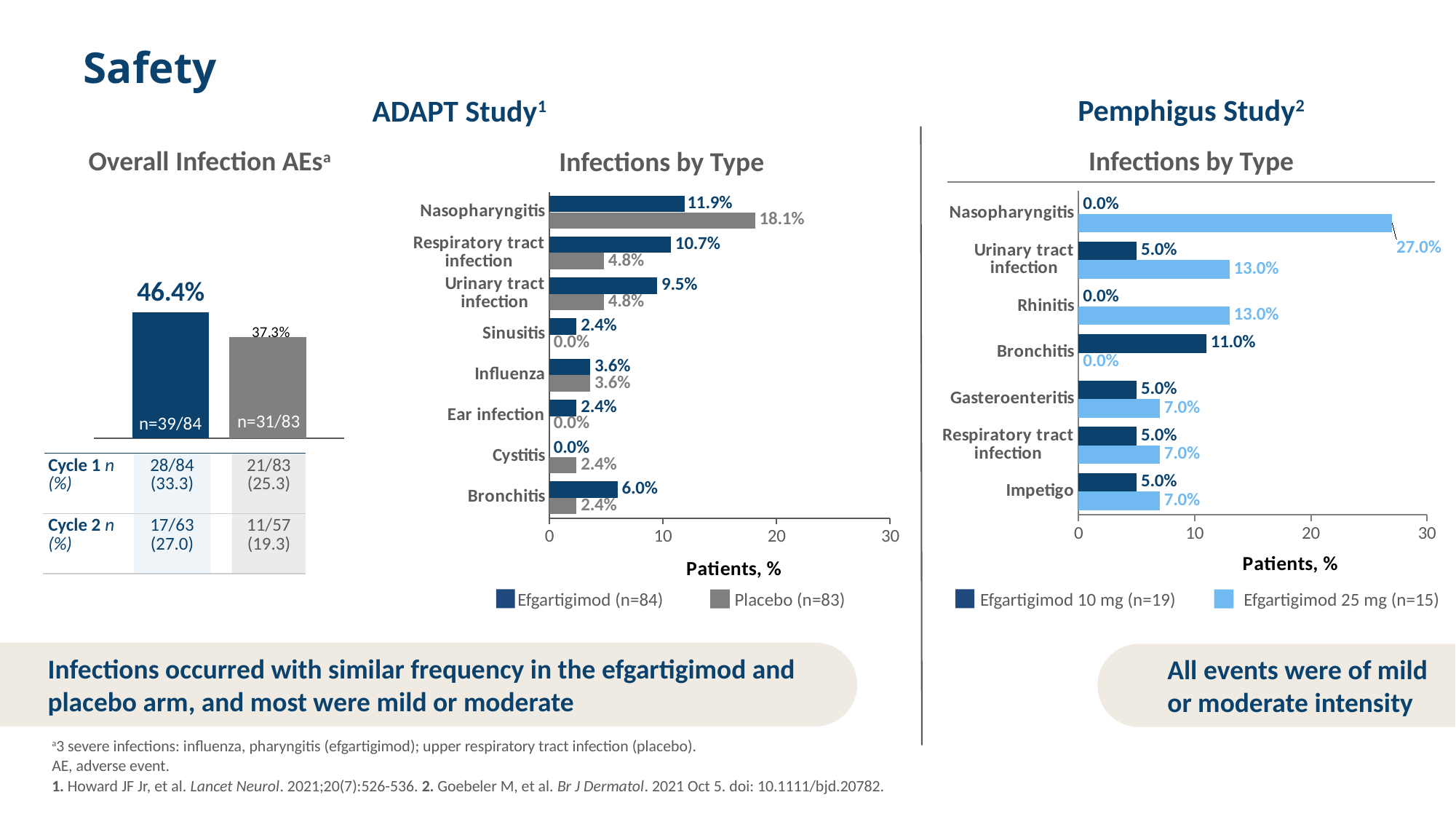
In the Overall Infection AEs chart, what percentage is shown for the efgartigimod bar? 46.4% In the ADAPT Study Infections by Type chart, what is the difference between the efgartigimod and placebo values for respiratory tract infection? 5.9% In the Pemphigus Study Infections by Type chart, how many series does the legend list? 2 In the ADAPT Study Infections by Type chart, which infection type has the highest efgartigimod value? Nasopharyngitis In the ADAPT Study Infections by Type chart, what is the placebo value for nasopharyngitis? 18.1% In the Pemphigus Study Infections by Type chart, which infection type has the highest efgartigimod 10 mg value? Bronchitis In the Pemphigus Study Infections by Type chart, what is the efgartigimod 25 mg value for nasopharyngitis? 27.0% In the Overall Infection AEs chart, what is the difference between the efgartigimod and placebo percentages? 9.1% In the Overall Infection AEs chart, what percentage is shown for the placebo bar? 37.3% What kind of chart is the Pemphigus Study Infections by Type chart? Bar chart In the ADAPT Study Infections by Type chart, how many infection types are listed? 8 In the ADAPT Study Infections by Type chart, which is larger for bronchitis, the efgartigimod value or the placebo value? Efgartigimod